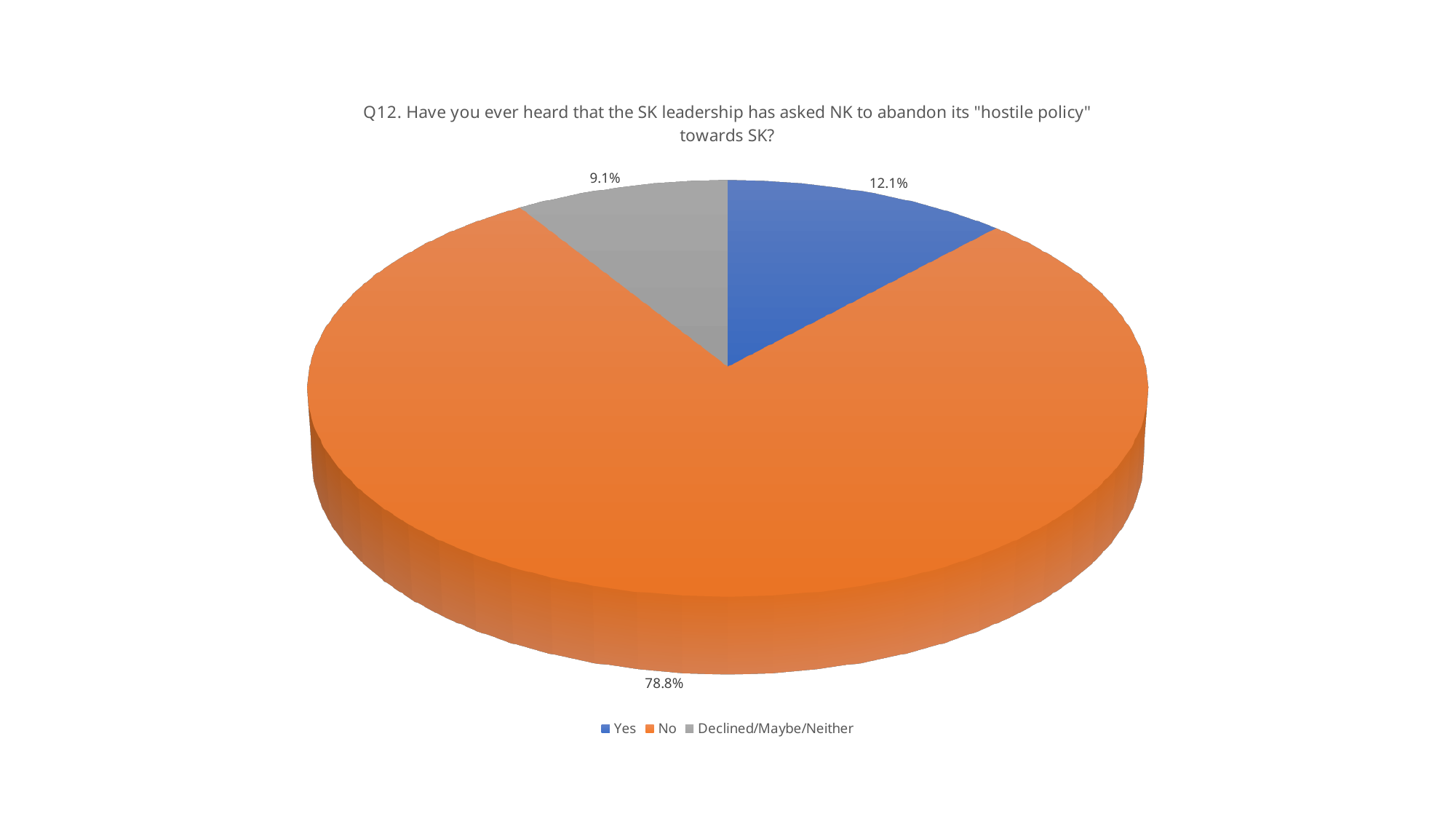
What percentage of respondents fall under "Declined/Maybe/Neither"? 9.1% What is the difference in percentage points between the "No" and "Yes" shares? 66.7 What percentage of respondents answered "No"? 78.8% What colour is the "No" slice in the pie chart? Orange Which response category has the smallest share of the pie? Declined/Maybe/Neither What is the title of the chart? Q12. Have you ever heard that the SK leadership has asked NK to abandon its "hostile policy" towards SK? Which response category has the largest share of the pie? No What percentage of respondents answered "Yes"? 12.1% How many categories does the pie chart show? 3 What kind of chart is shown on the slide? Pie chart What is the difference in percentage points between the "Yes" and "Declined/Maybe/Neither" shares? 3.0 Which is larger, the share for "Yes" or the share for "Declined/Maybe/Neither"? Yes